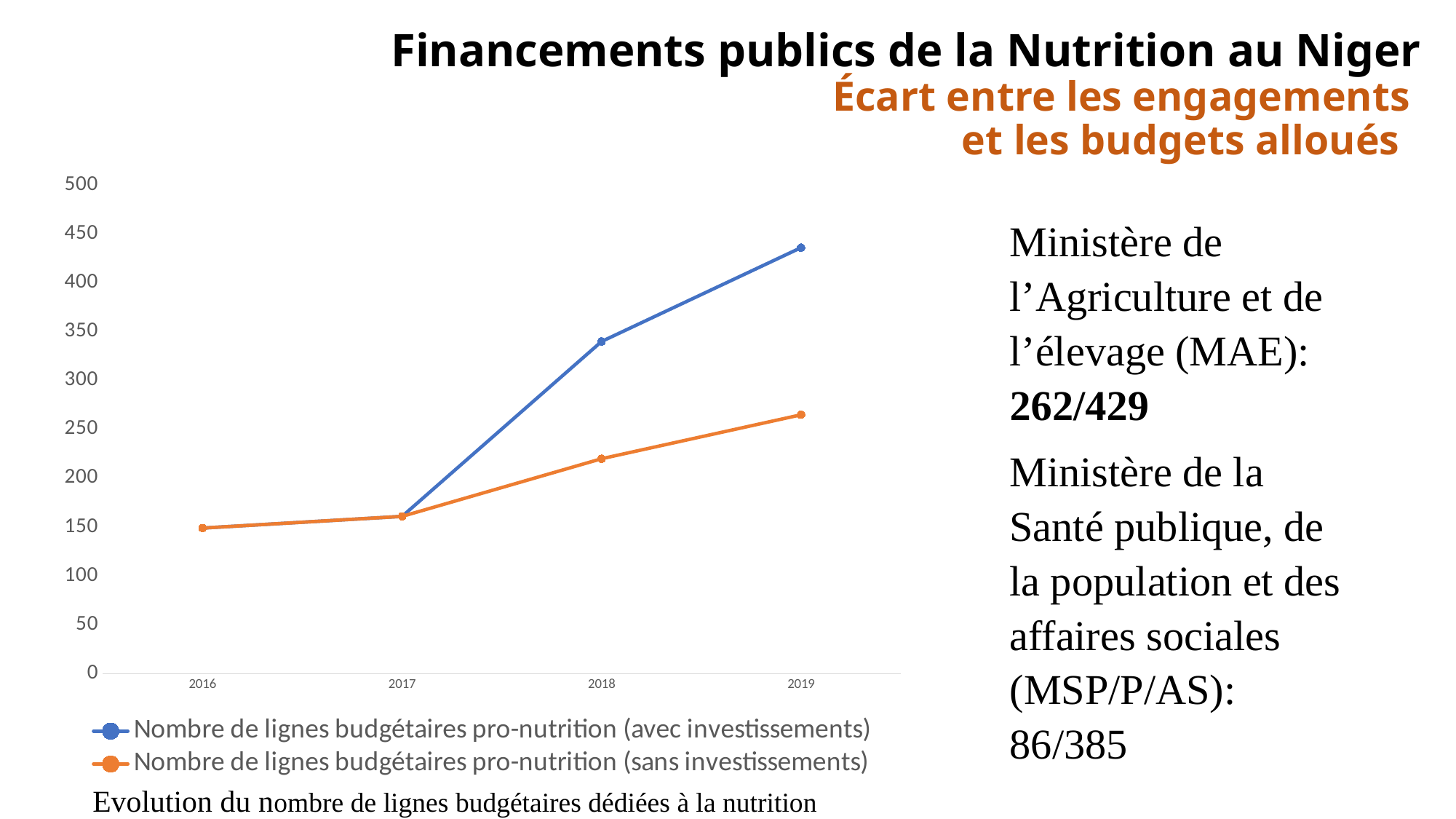
In 2019, which series has the larger value: 'avec investissements' or 'sans investissements'? avec investissements What kind of chart is shown on the slide? line chart How many series does the legend list? 2 Is the value for 'Nombre de lignes budgétaires pro-nutrition (sans investissements)' in 2018 greater or less than 250? less How many years are plotted along the x axis? 4 Is the value for 'Nombre de lignes budgétaires pro-nutrition (avec investissements)' in 2016 greater or less than 200? less In which year does the 'Nombre de lignes budgétaires pro-nutrition (avec investissements)' series reach its highest value? 2019 What colour is the line for 'Nombre de lignes budgétaires pro-nutrition (sans investissements)'? orange Is the value for 'Nombre de lignes budgétaires pro-nutrition (avec investissements)' in 2019 greater or less than 400? greater Do the values of the 'sans investissements' series rise or fall from 2016 to 2019? rise